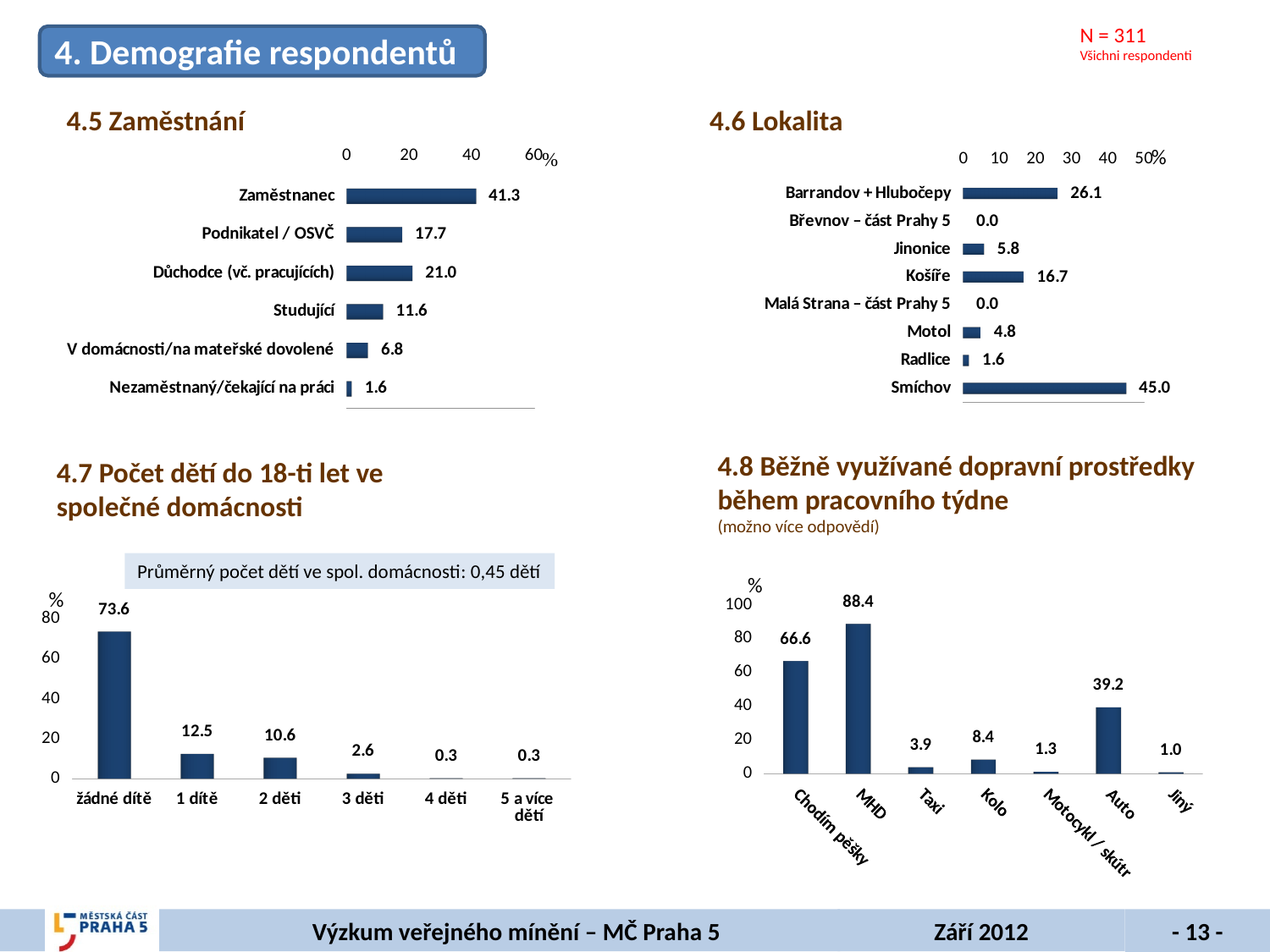
In the '4.5 Zaměstnání' chart, what is the difference between Důchodce (vč. pracujících) and Studující? 9.4 In the '4.5 Zaměstnání' chart, which category has the highest value? Zaměstnanec In the '4.6 Lokalita' chart, what is the value for Košíře? 16.7 In the '4.6 Lokalita' chart, which locality has the highest value? Smíchov In the '4.8 Běžně využívané dopravní prostředky během pracovního týdne' chart, what is the value for Auto? 39.2 In the '4.8 Běžně využívané dopravní prostředky během pracovního týdne' chart, what is the difference between MHD and Chodím pěšky? 21.8 In the '4.6 Lokalita' chart, how many localities are listed? 8 In the '4.6 Lokalita' chart, which is larger, Jinonice or Motol? Jinonice In the '4.7 Počet dětí do 18-ti let ve společné domácnosti' chart, what is the value for 1 dítě? 12.5 In the '4.5 Zaměstnání' chart, what is the value for Podnikatel / OSVČ? 17.7 In the '4.8 Běžně využívané dopravní prostředky během pracovního týdne' chart, which category has the lowest value? Jiný In the '4.7 Počet dětí do 18-ti let ve společné domácnosti' chart, what kind of chart is shown? bar chart